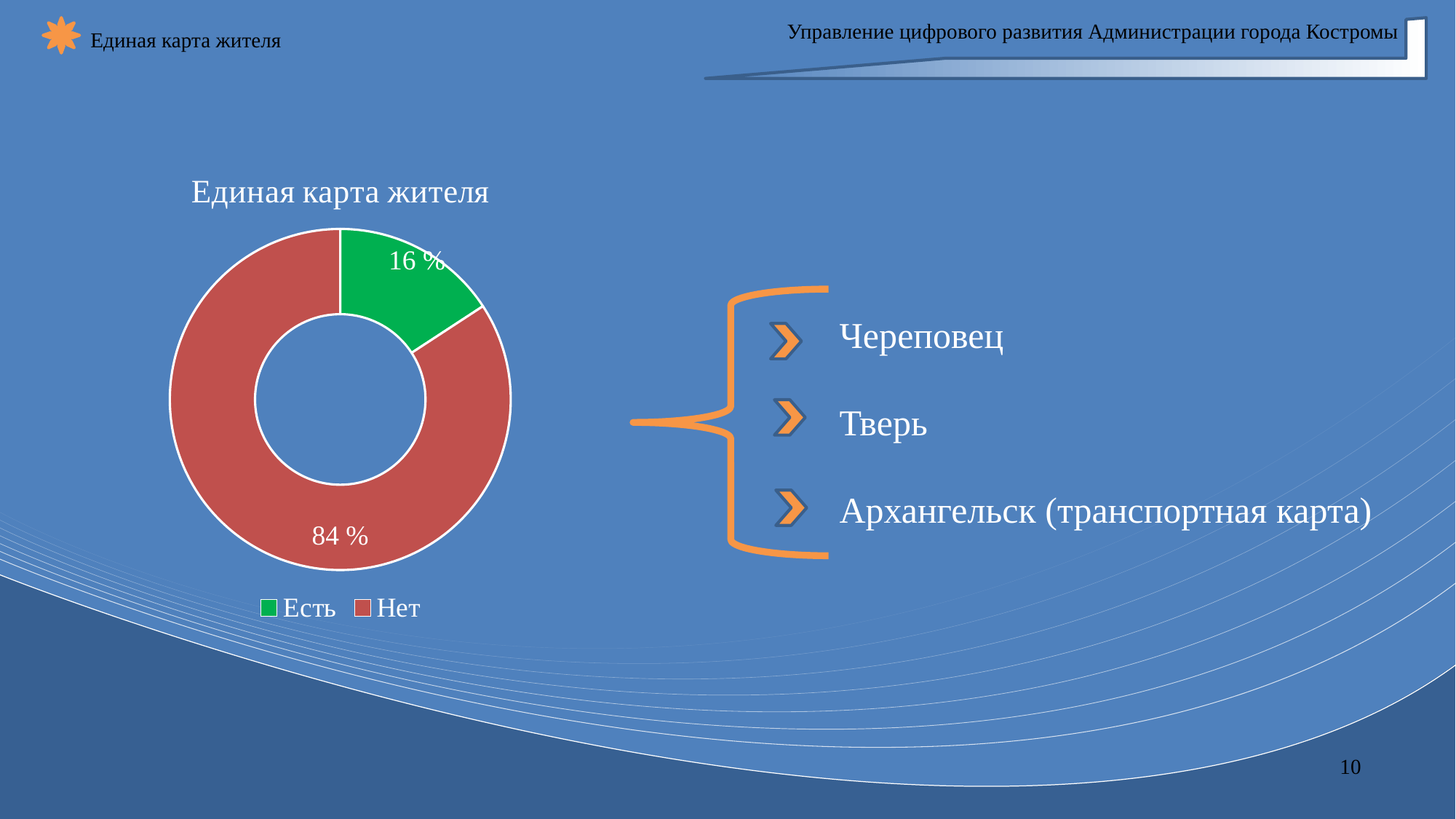
What is the value for the 'Есть' slice? 16 % What is the value for the 'Нет' slice? 84 % What colour represents the 'Есть' category? Green How many entries does the legend list? 2 What share of the chart does the 'Нет' slice take? 84 % What is the difference between the 'Нет' and 'Есть' values? 68 % What kind of chart is shown on the slide? Doughnut chart Which is larger, the 'Есть' slice or the 'Нет' slice? Нет What is the title of the chart? Единая карта жителя How many categories does the chart show? 2 Which category has the largest share of the chart? Нет Which category has the smallest share of the chart? Есть